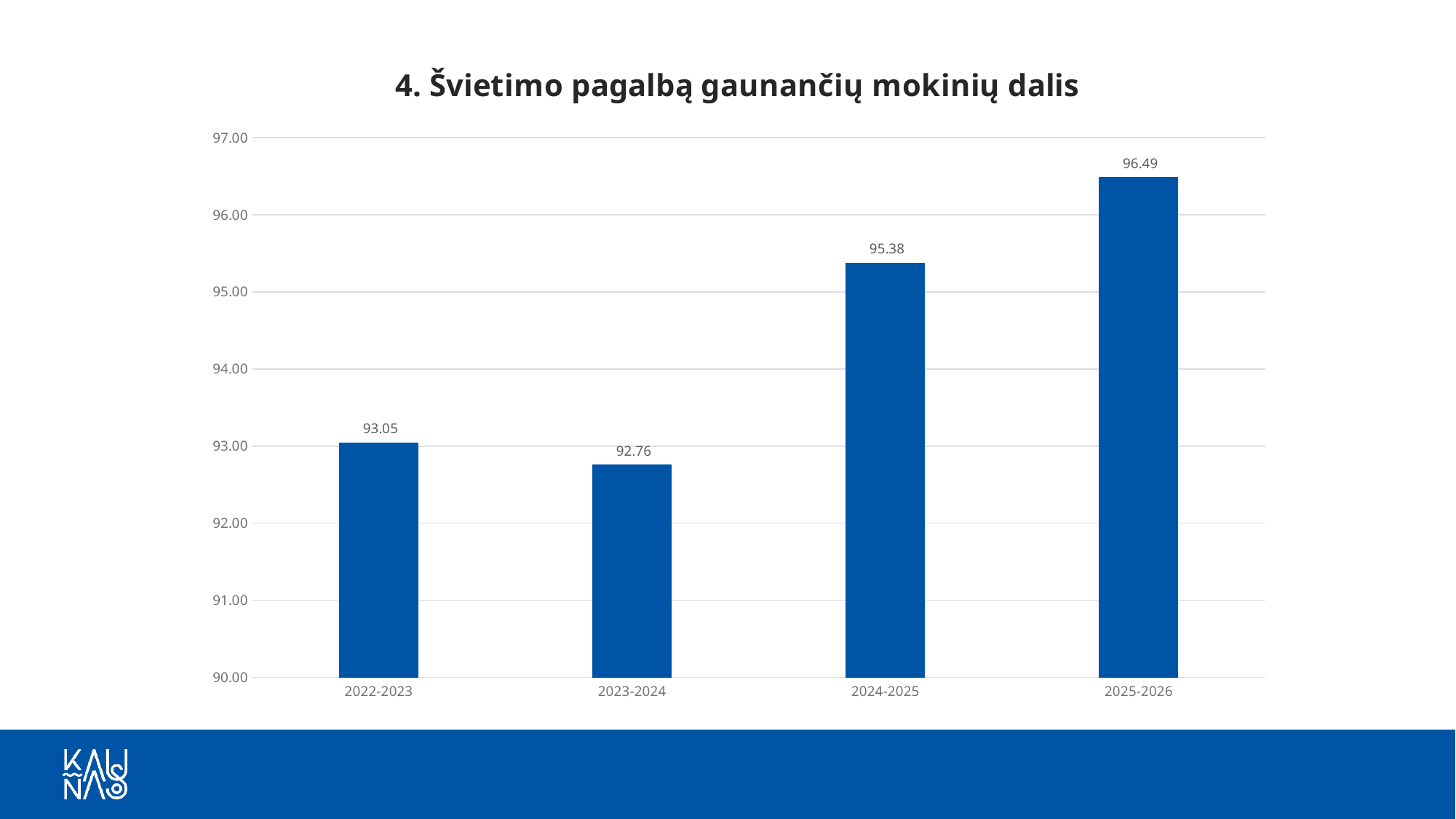
What is the difference between the values for 2025-2026 and 2024-2025? 1.11 Is the value for 2024-2025 greater or less than 95.00? greater Which category has the highest value? 2025-2026 Which category has the lowest value? 2023-2024 What is the difference between the values for 2022-2023 and 2023-2024? 0.29 What is the value for 2023-2024? 92.76 How many categories are shown on the x axis? 4 What kind of chart is shown on the slide? bar chart What is the value for 2022-2023? 93.05 What is the value for 2024-2025? 95.38 Which is larger, the value for 2024-2025 or the value for 2022-2023? 2024-2025 What is the value for 2025-2026? 96.49